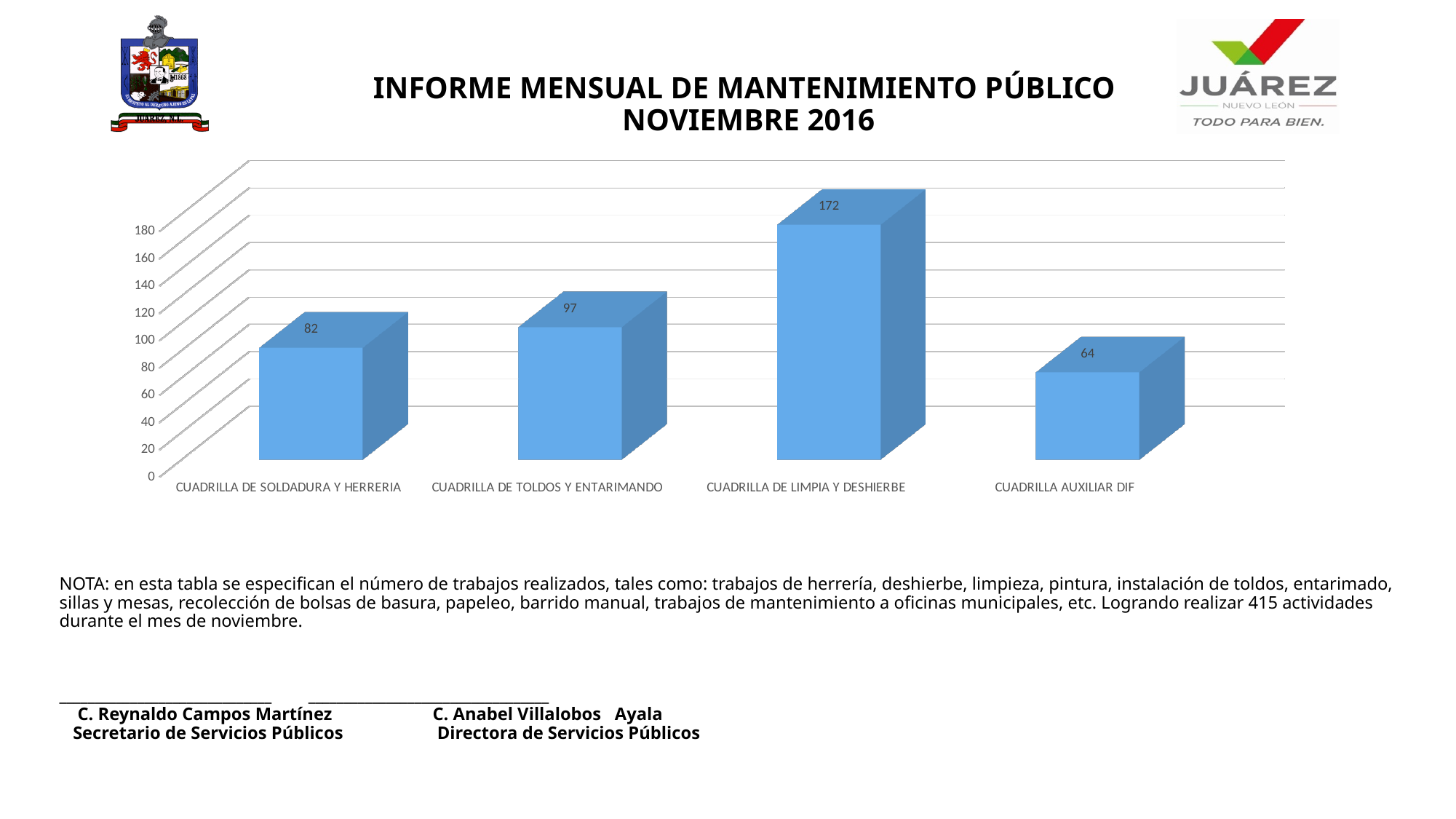
What is the value for CUADRILLA AUXILIAR DIF? 64 What kind of chart is shown on the slide? bar chart What is the value for CUADRILLA DE SOLDADURA Y HERRERIA? 82 Which is larger, the value for CUADRILLA DE SOLDADURA Y HERRERIA or CUADRILLA DE TOLDOS Y ENTARIMANDO? CUADRILLA DE TOLDOS Y ENTARIMANDO What is the value for CUADRILLA DE LIMPIA Y DESHIERBE? 172 Which category has the lowest value? CUADRILLA AUXILIAR DIF What is the difference between the values for CUADRILLA DE TOLDOS Y ENTARIMANDO and CUADRILLA DE SOLDADURA Y HERRERIA? 15 What is the title shown above the chart? INFORME MENSUAL DE MANTENIMIENTO PÚBLICO NOVIEMBRE 2016 How many categories are shown in the chart? 4 Which category has the highest value? CUADRILLA DE LIMPIA Y DESHIERBE What is the value for CUADRILLA DE TOLDOS Y ENTARIMANDO? 97 What is the difference between the values for CUADRILLA DE LIMPIA Y DESHIERBE and CUADRILLA AUXILIAR DIF? 108